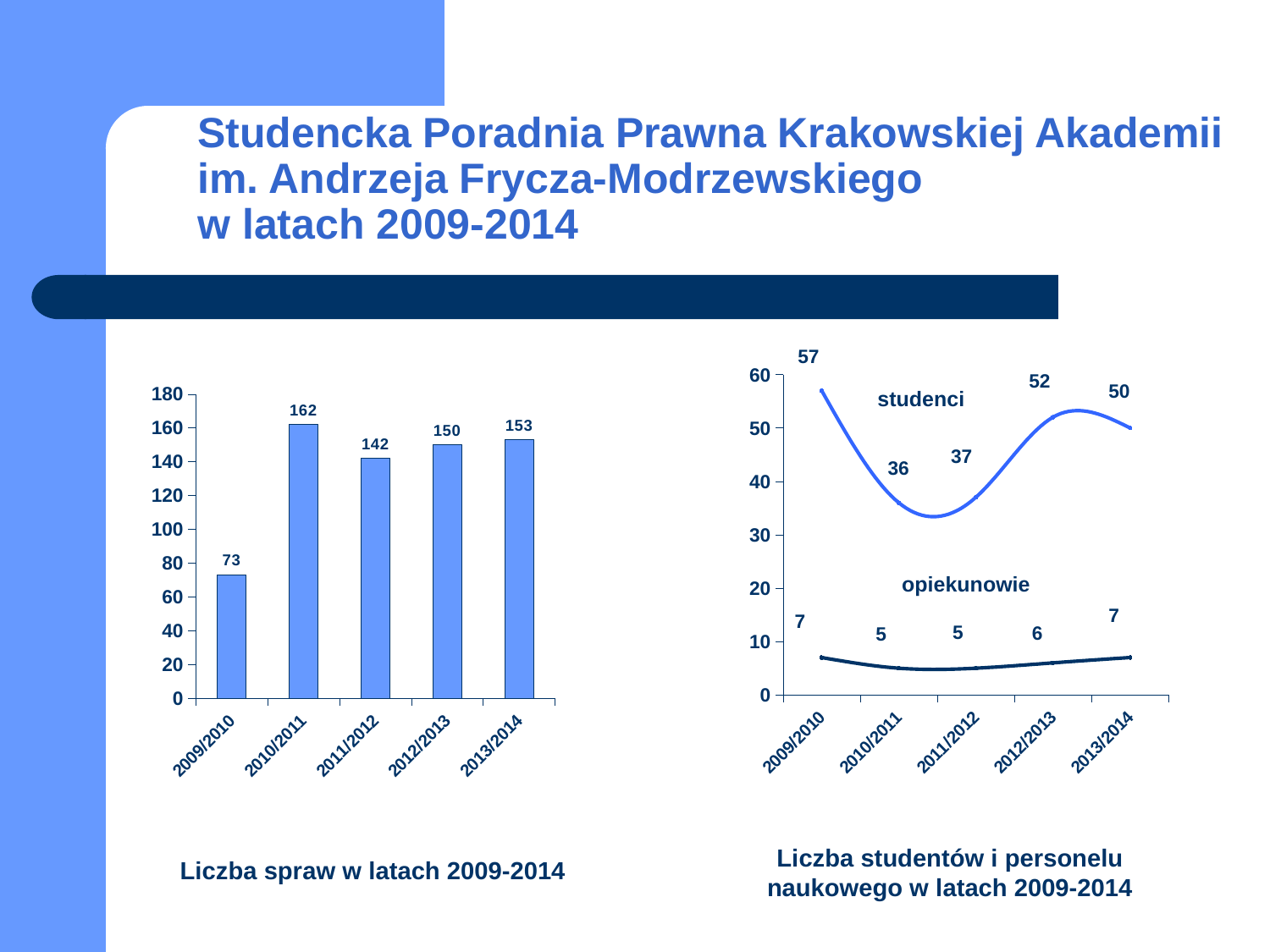
In the chart 'Liczba studentów i personelu naukowego w latach 2009-2014', which is larger: studenci in 2010/2011 or studenci in 2011/2012? studenci in 2011/2012 In the chart 'Liczba spraw w latach 2009-2014', which year has the highest value? 2010/2011 What kind of chart is 'Liczba spraw w latach 2009-2014'? bar chart In the chart 'Liczba studentów i personelu naukowego w latach 2009-2014', what is the value for studenci in 2012/2013? 52 What kind of chart is 'Liczba studentów i personelu naukowego w latach 2009-2014'? line chart In the chart 'Liczba spraw w latach 2009-2014', which year has the lowest value? 2009/2010 In the chart 'Liczba studentów i personelu naukowego w latach 2009-2014', what is the difference between studenci and opiekunowie in 2013/2014? 43 In the chart 'Liczba studentów i personelu naukowego w latach 2009-2014', in which year is the studenci value highest? 2009/2010 In the chart 'Liczba spraw w latach 2009-2014', what is the value for 2011/2012? 142 In the chart 'Liczba spraw w latach 2009-2014', what is the difference between the values for 2010/2011 and 2009/2010? 89 In the chart 'Liczba studentów i personelu naukowego w latach 2009-2014', what is the value for opiekunowie in 2012/2013? 6 In the chart 'Liczba spraw w latach 2009-2014', how many years are shown on the x axis? 5